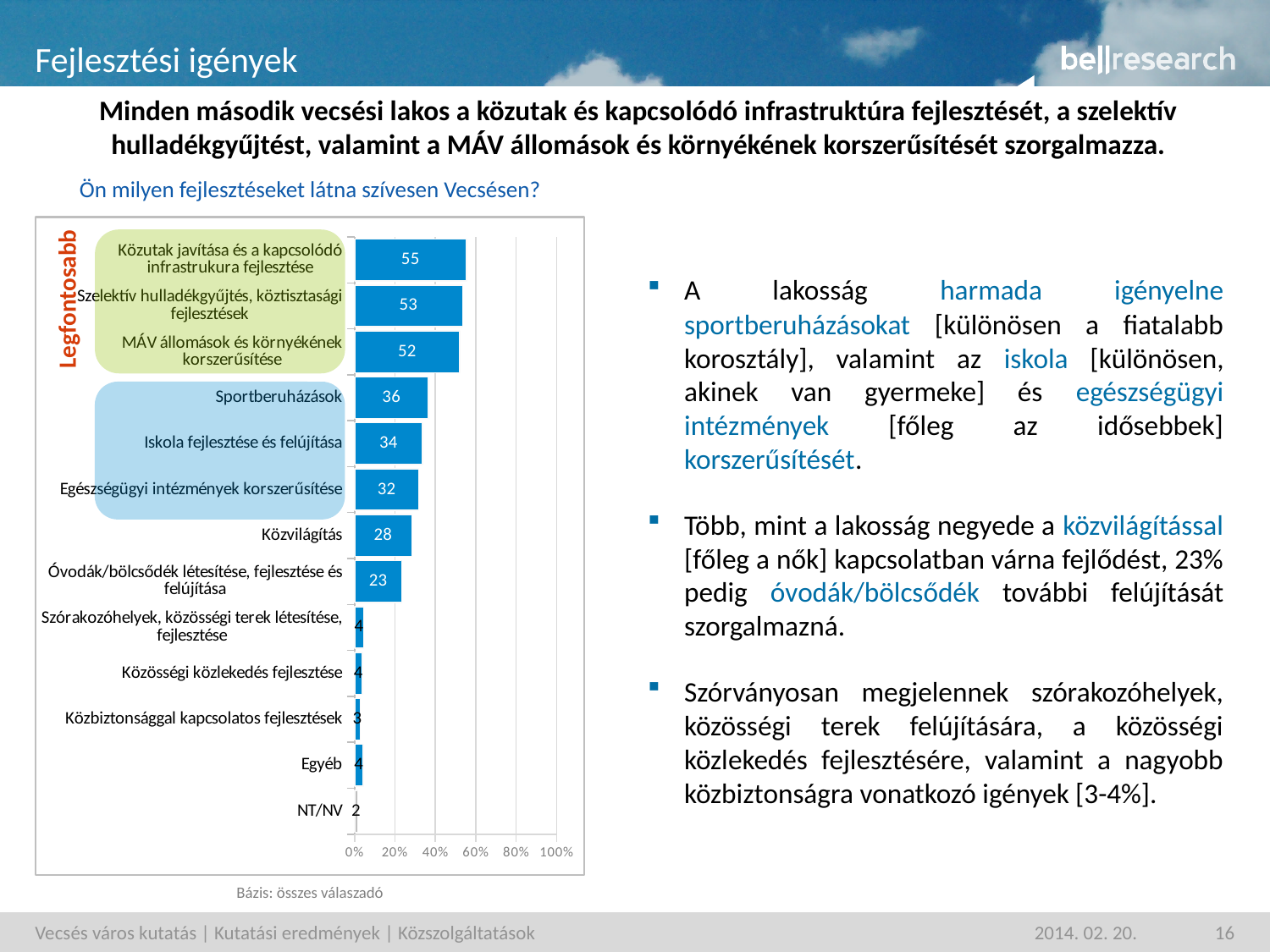
What is the value for "Sportberuházások"? 36 Which is larger, the value for "Egészségügyi intézmények korszerűsítése" or the value for "Közvilágítás"? Egészségügyi intézmények korszerűsítése Is the value for "Óvodák/bölcsődék létesítése, fejlesztése és felújítása" greater or less than 40%? less What is the value for "Iskola fejlesztése és felújítása"? 34 Which category has the lowest value? NT/NV What is the difference between the values for "Közutak javítása és a kapcsolódó infrastrukura fejlesztése" and "Sportberuházások"? 19 What is the value for "Közbiztonsággal kapcsolatos fejlesztések"? 3 What is the question shown above the chart? Ön milyen fejlesztéseket látna szívesen Vecsésen? How many categories are shown in the chart? 13 What is the value for "Közvilágítás"? 28 What kind of chart is shown on the slide? bar chart Which category has the highest value? Közutak javítása és a kapcsolódó infrastrukura fejlesztése